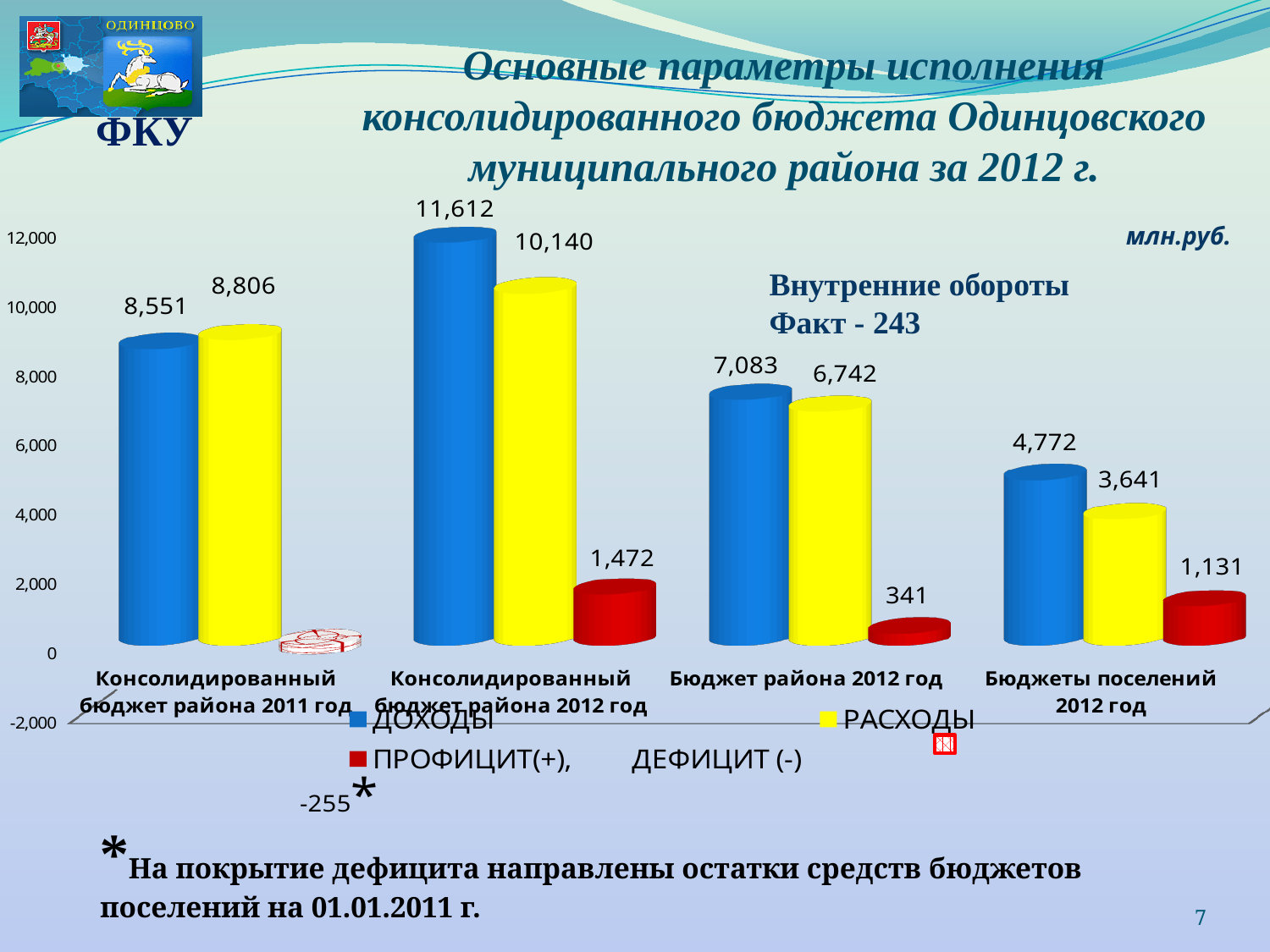
Which is larger for Консолидированный бюджет района 2011 год: ДОХОДЫ or РАСХОДЫ? РАСХОДЫ What is the value of ПРОФИЦИТ(+), ДЕФИЦИТ(-) for Бюджет района 2012 год? 341 What kind of chart is shown on the slide? Bar chart What is the difference between ДОХОДЫ and РАСХОДЫ for Консолидированный бюджет района 2012 год? 1,472 How many categories are shown on the x axis of the chart? 4 Which category has the highest ДОХОДЫ value? Консолидированный бюджет района 2012 год What is the value of ДОХОДЫ for Консолидированный бюджет района 2011 год? 8,551 What is the value of РАСХОДЫ for Бюджеты поселений 2012 год? 3,641 What is the value of ДОХОДЫ for Консолидированный бюджет района 2012 год? 11,612 How many series does the chart legend list? 3 Which category has the lowest РАСХОДЫ value? Бюджеты поселений 2012 год What unit of measurement is indicated for the chart values? млн.руб.